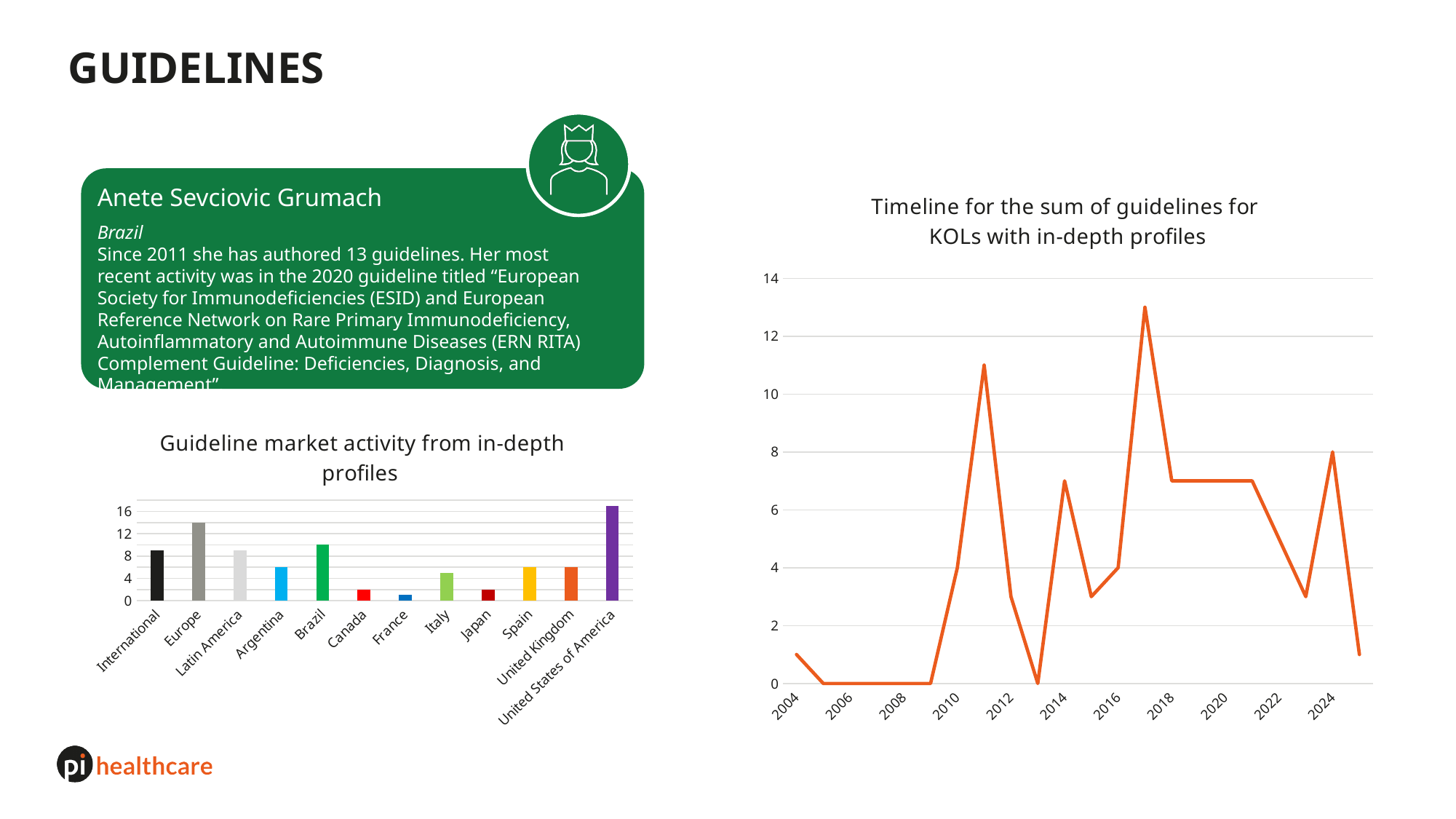
In the 'Guideline market activity from in-depth profiles' chart, is the value for Europe greater or less than 12? greater In the 'Guideline market activity from in-depth profiles' chart, is the value for United States of America greater or less than 16? greater In the 'Guideline market activity from in-depth profiles' chart, which is larger, Europe or Brazil? Europe In the 'Timeline for the sum of guidelines for KOLs with in-depth profiles' chart, is the value for 2008 greater or less than 2? less What kind of chart is 'Guideline market activity from in-depth profiles'? bar chart How many categories are shown in the 'Guideline market activity from in-depth profiles' chart? 12 In the 'Guideline market activity from in-depth profiles' chart, which category has the highest value? United States of America In the 'Timeline for the sum of guidelines for KOLs with in-depth profiles' chart, what is the highest value shown on the vertical axis? 14 In the 'Guideline market activity from in-depth profiles' chart, which category has the lowest value? France What kind of chart is 'Timeline for the sum of guidelines for KOLs with in-depth profiles'? line chart